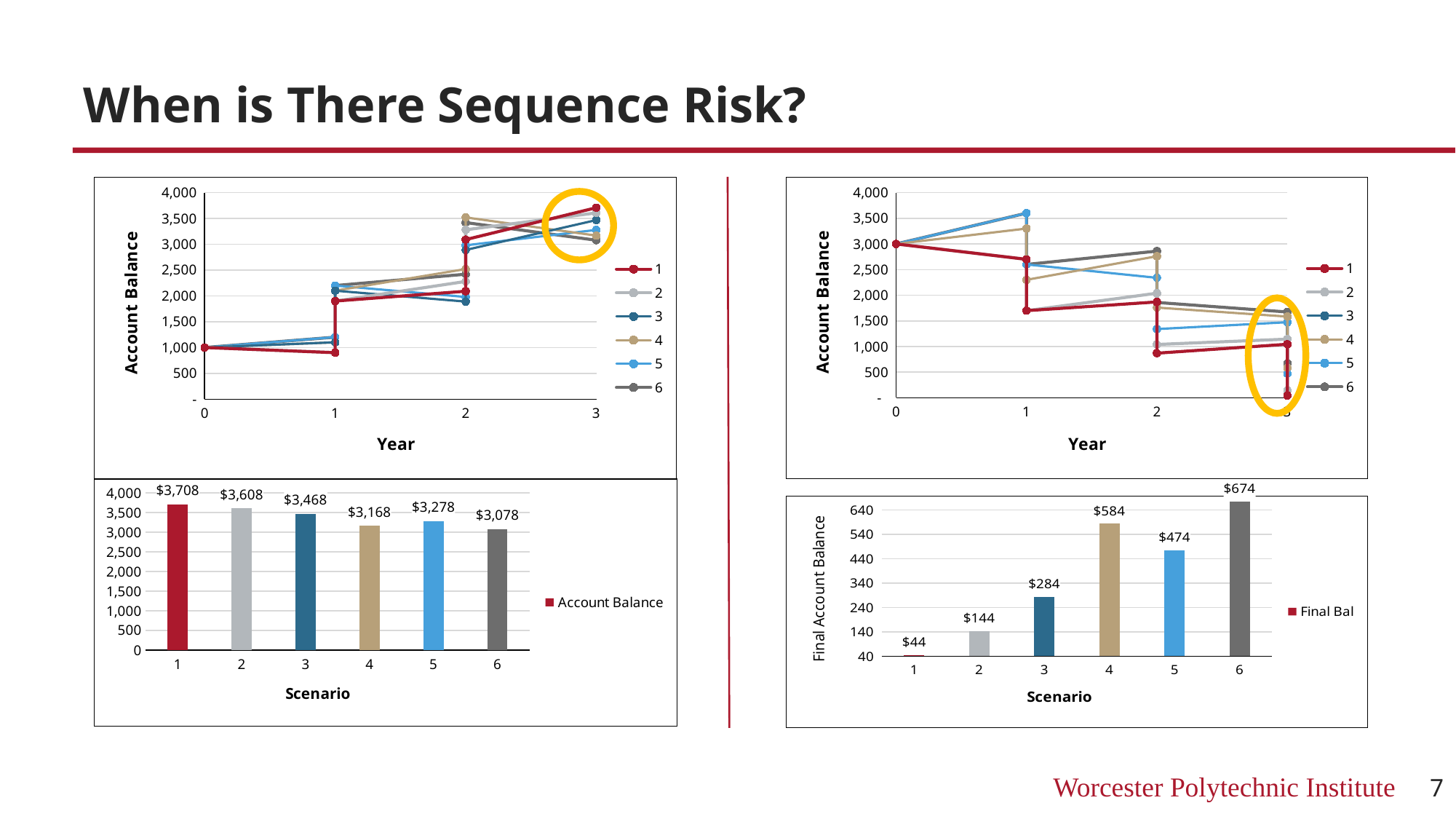
In the bottom-left bar chart, what is the account balance for scenario 1? $3,708 In the bottom-left bar chart, which is larger: the account balance for scenario 4 or scenario 5? Scenario 5 What is the legend entry of the bottom-right bar chart? Final Bal In the top-right line chart, does series 1 rise or fall from year 0 to year 3? Fall How many series does the legend of the top-left line chart list? 6 In the bottom-left bar chart, what is the difference between the account balances of scenario 1 and scenario 6? $630 What type of chart is the top-right chart on the slide? Line chart In the bottom-right bar chart, which scenario has the highest final account balance? 6 In the bottom-left bar chart, which scenario has the lowest account balance? 6 In the bottom-right bar chart, what is the final account balance for scenario 3? $284 How many scenarios are shown in the bottom-right bar chart? 6 In the bottom-right bar chart, what is the difference between the final balances of scenario 4 and scenario 5? $110